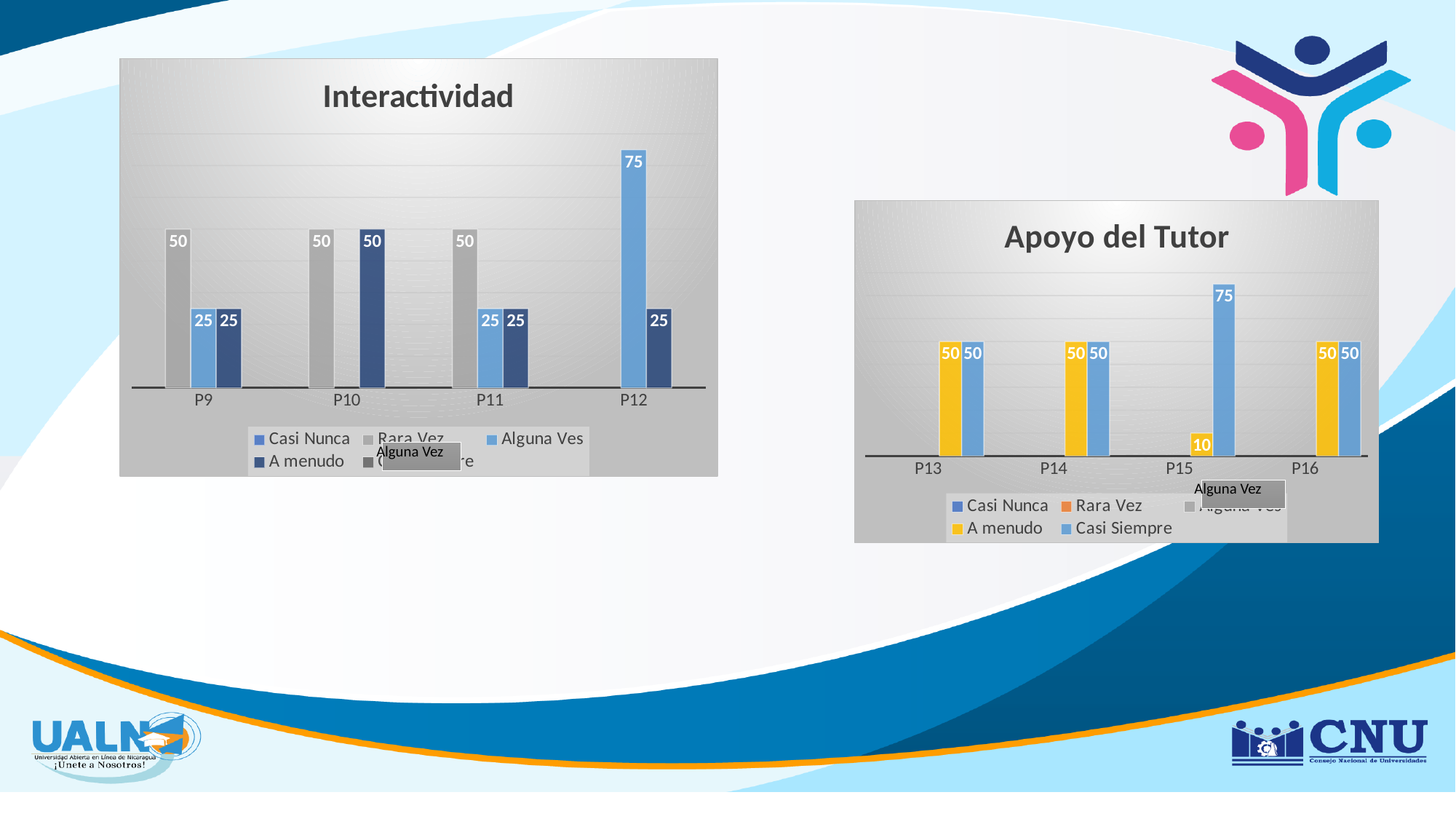
In the Interactividad chart, what is the value of Rara Vez for P9? 50 In the Interactividad chart, what is the value of Alguna Ves for P12? 75 In the Interactividad chart, what is the difference between Alguna Ves and A menudo for P12? 50 In the Interactividad chart, which category contains the tallest bar? P12 In the Interactividad chart, how many categories are shown on the x axis? 4 In the Apoyo del Tutor chart, what is the value of Casi Siempre for P15? 75 In the Apoyo del Tutor chart, which category has the lowest bar? P15 In the Apoyo del Tutor chart, how many series does the legend list? 5 In the Apoyo del Tutor chart, what is the difference between Casi Siempre and A menudo for P15? 65 In the Interactividad chart, what is the value of A menudo for P10? 50 What kind of chart is the Interactividad chart? Bar chart In the Apoyo del Tutor chart, what is the value of A menudo for P15? 10